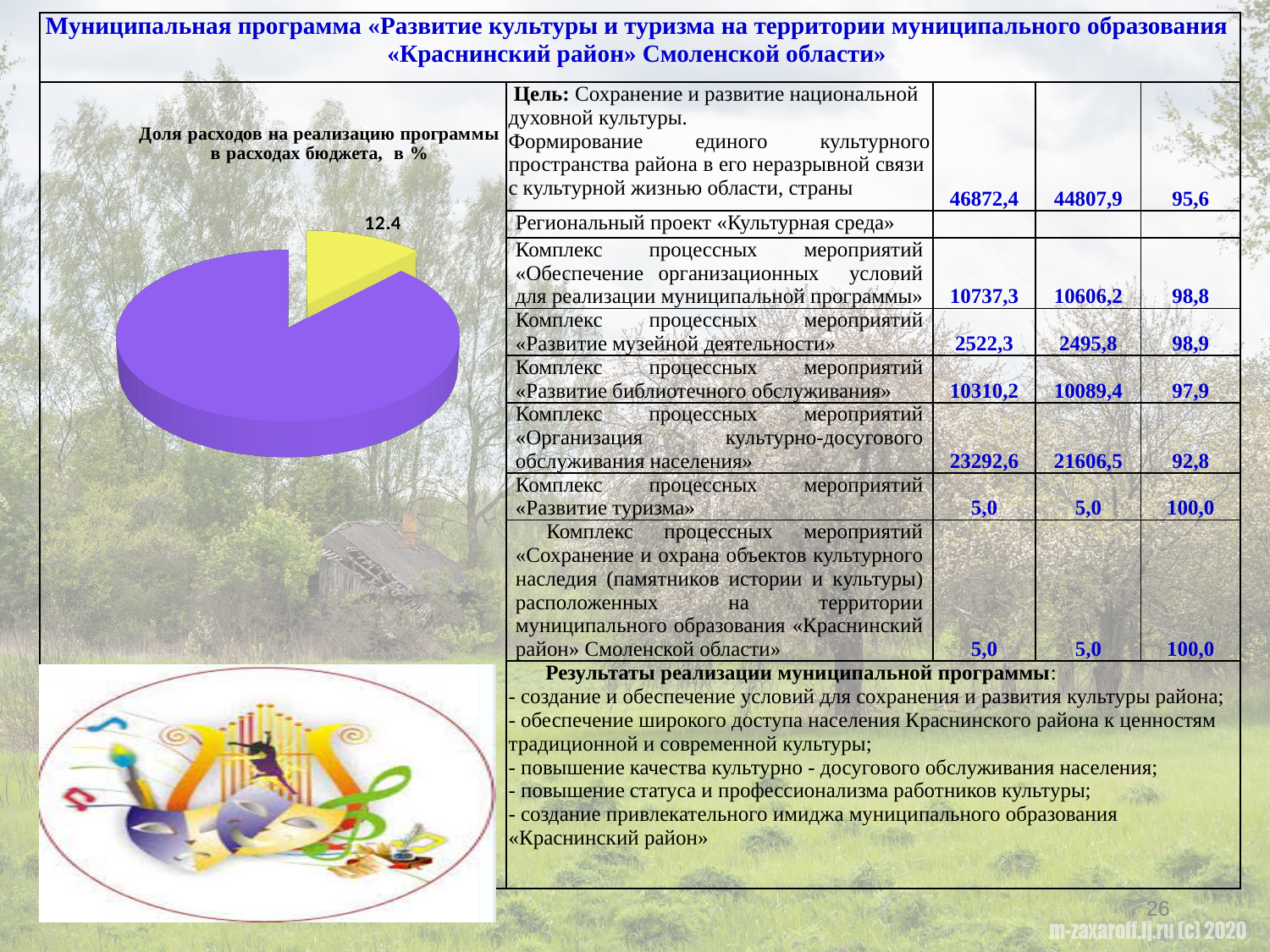
How many slices does the pie chart have? 2 Which slice of the pie chart is the smallest? the yellow slice (12.4) What value is printed on the yellow slice of the pie chart? 12.4 What is the title of the pie chart? Доля расходов на реализацию программы в расходах бюджета, в % What kind of chart is shown on the left of the slide? pie chart Which slice of the pie chart is larger, the purple one or the yellow one? the purple one What colour is the slice labelled 12.4 in the pie chart? yellow